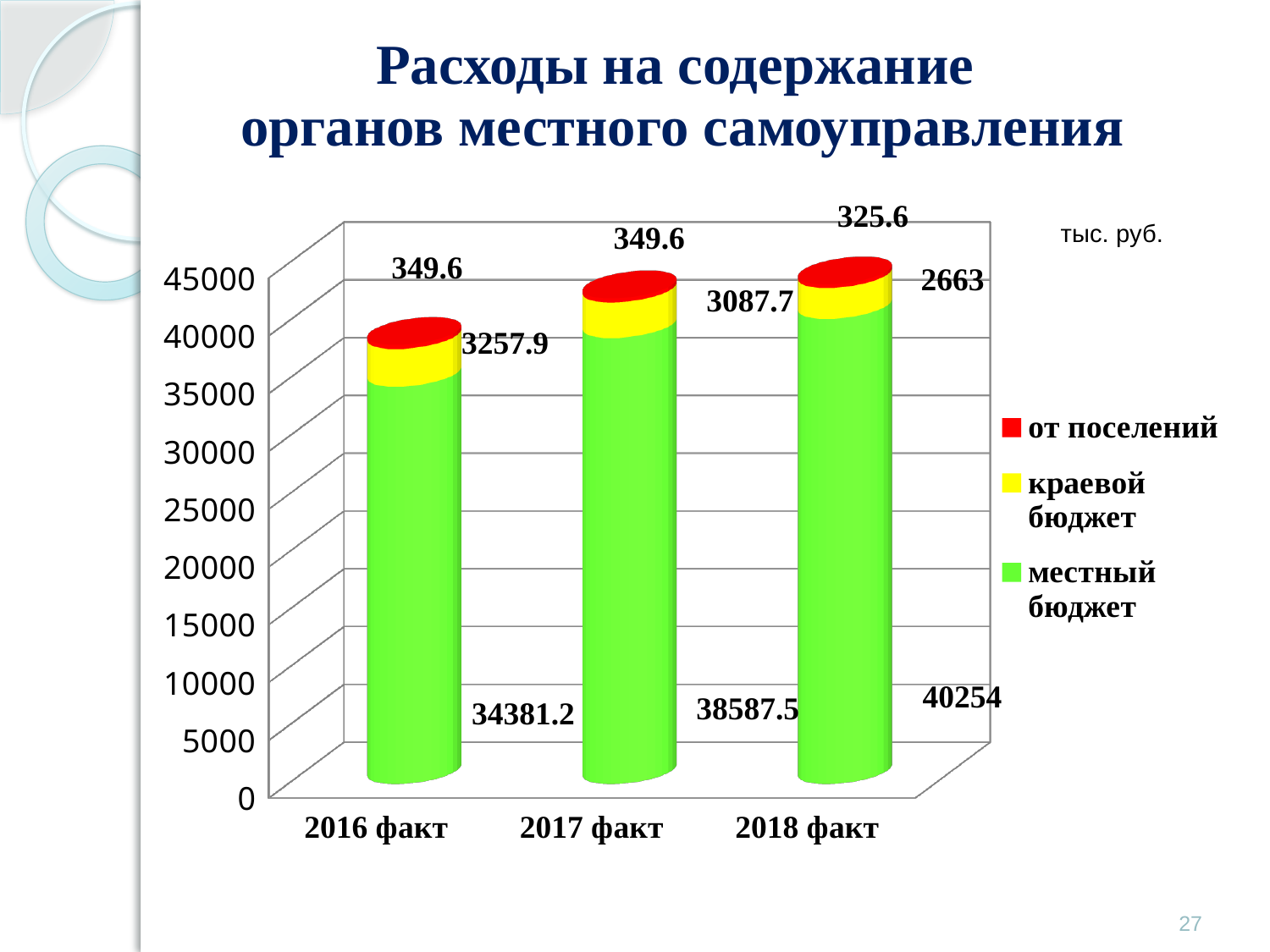
What is the value of местный бюджет for 2016 факт? 34381.2 How many series does the legend list? 3 What kind of chart is shown on the slide? Stacked bar chart Which year has the lowest value for краевой бюджет? 2018 факт How many categories are shown on the x axis? 3 Does the value of местный бюджет rise or fall from 2016 факт to 2018 факт? Rises What is the value of от поселений for 2017 факт? 349.6 Which year has the highest value for местный бюджет? 2018 факт What is the value of краевой бюджет for 2018 факт? 2663 Which is larger: краевой бюджет for 2016 факт or for 2017 факт? 2016 факт What is the total of the stacked bar for 2016 факт? 37988.7 What is the difference in местный бюджет between 2018 факт and 2017 факт? 1666.5